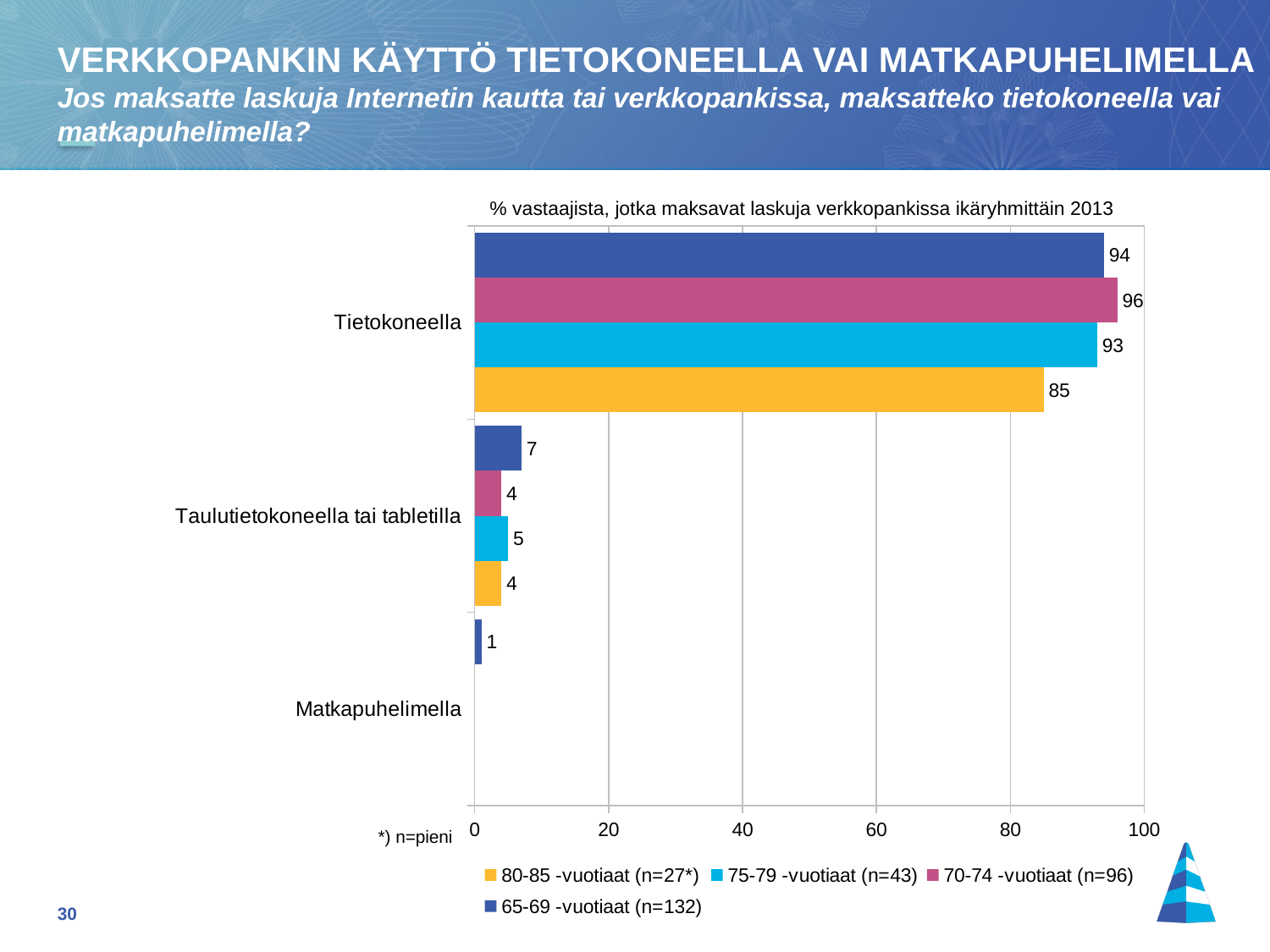
What is the value for 70-74 -vuotiaat in the Tietokoneella category? 96 What kind of chart is shown on the slide? bar chart What is the sample size (n) given in the legend for 65-69 -vuotiaat? 132 Which age group has the lowest value in the Tietokoneella category? 80-85 -vuotiaat What is the value for 80-85 -vuotiaat in the Tietokoneella category? 85 How many series does the legend list? 4 What is the difference between the 70-74 -vuotiaat and 80-85 -vuotiaat values in the Tietokoneella category? 11 How many categories are shown on the vertical axis? 3 Which age group has the highest value in the Tietokoneella category? 70-74 -vuotiaat What is the value for 65-69 -vuotiaat in the Taulutietokoneella tai tabletilla category? 7 What is the value for 65-69 -vuotiaat in the Matkapuhelimella category? 1 In the Taulutietokoneella tai tabletilla category, which is larger: the value for 65-69 -vuotiaat or for 75-79 -vuotiaat? 65-69 -vuotiaat